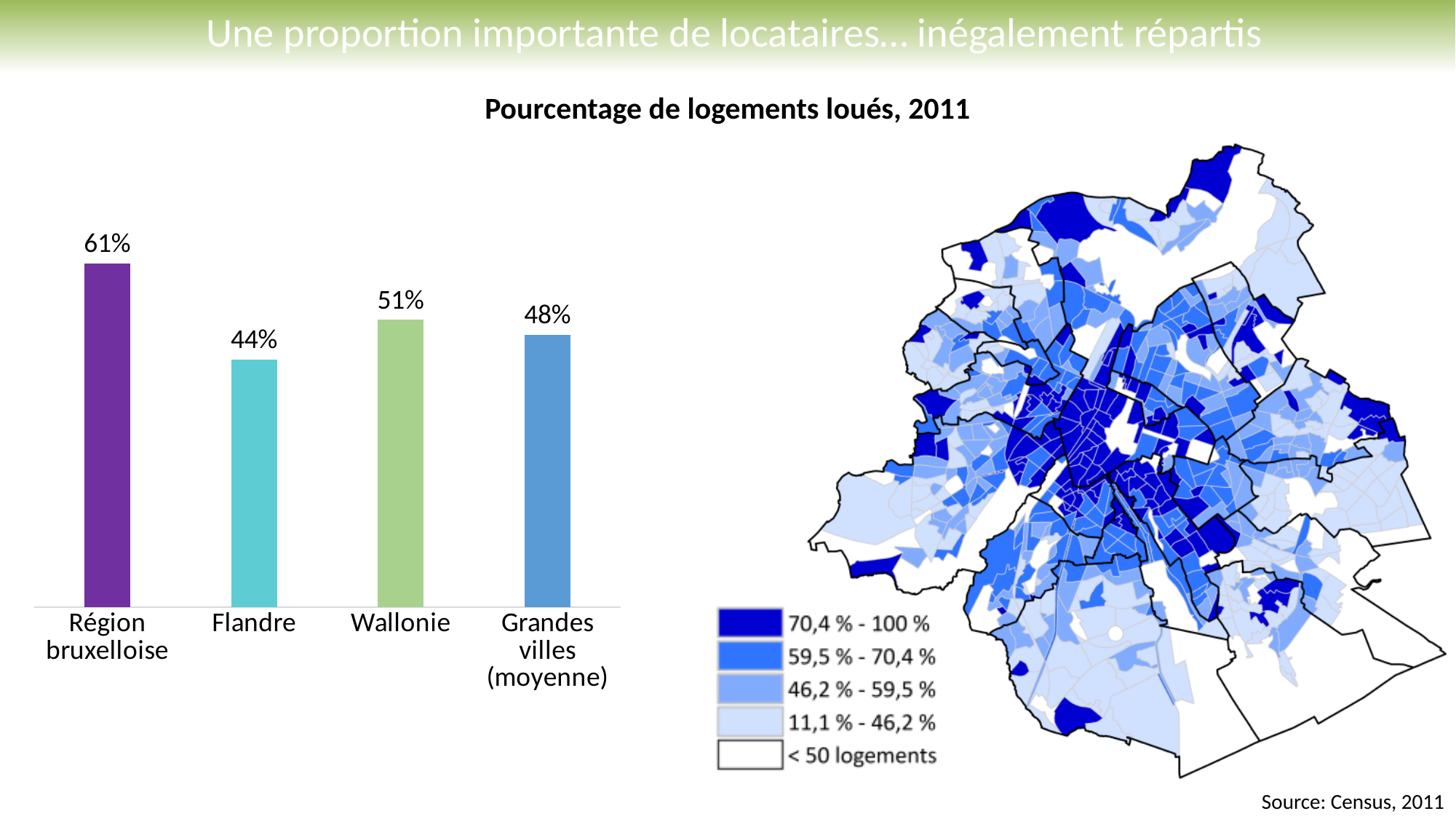
Which category has the highest value in the bar chart? Région bruxelloise Which category has the lowest value in the bar chart? Flandre Which is larger, the value for Wallonie or the value for Flandre? Wallonie What kind of chart is shown on the left of the slide? Bar chart What is the value for Flandre in the bar chart? 44% What is the title of the bar chart? Pourcentage de logements loués, 2011 What is the value for Grandes villes (moyenne) in the bar chart? 48% What is the value for Région bruxelloise in the bar chart? 61% What is the difference between the values for Wallonie and Grandes villes (moyenne)? 3% What is the difference between the values for Région bruxelloise and Flandre? 17% What is the value for Wallonie in the bar chart? 51% How many categories are shown in the bar chart? 4